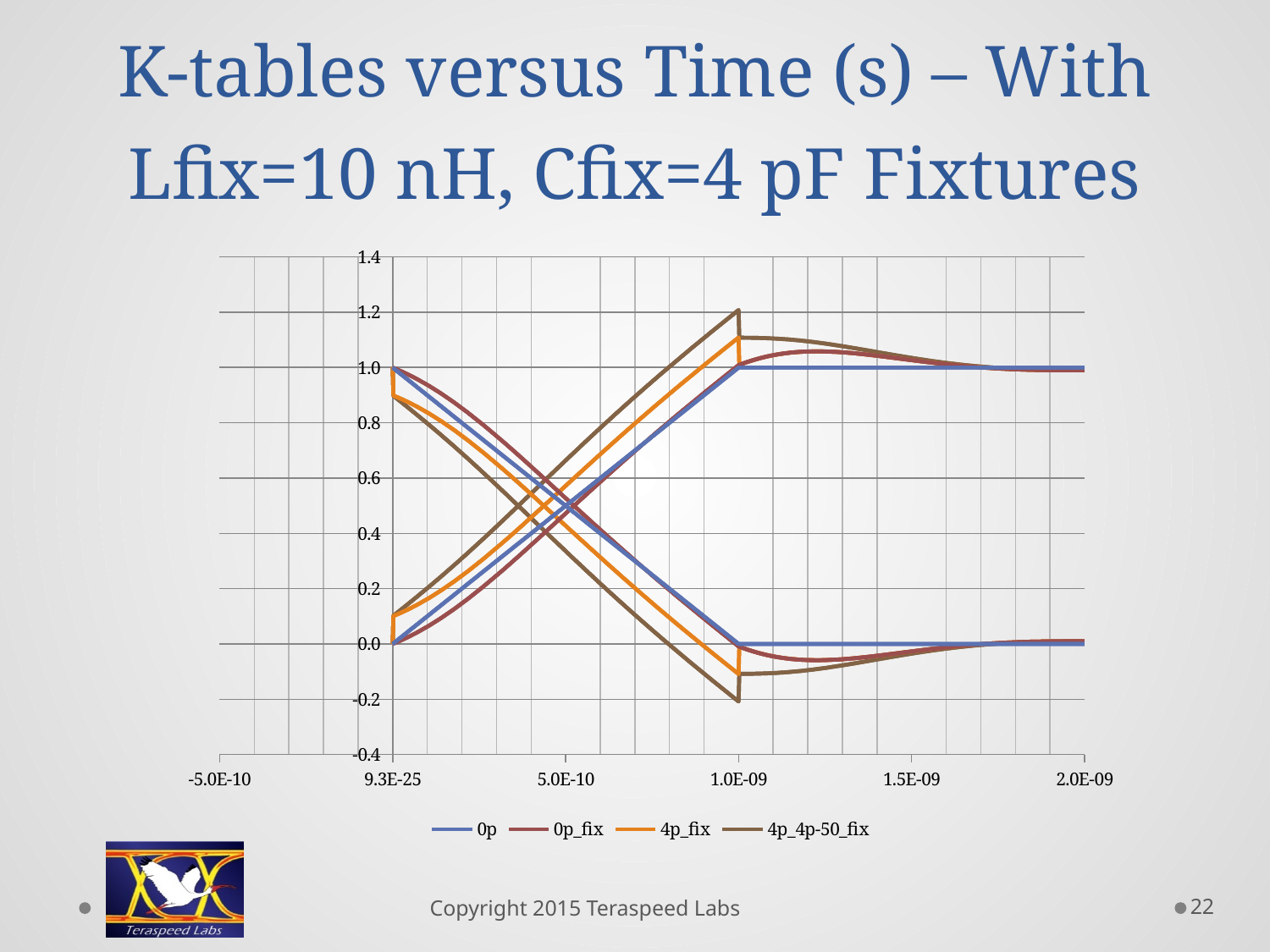
What are the series names listed in the legend? 0p, 0p_fix, 4p_fix, 4p_4p-50_fix How many tick labels are shown on the x axis? 6 Is the peak value of the 4p_fix series greater or less than 1.0? greater Which series dips to the lowest value on the chart? 4p_4p-50_fix Is the lowest value of the 4p_4p-50_fix series greater or less than 0.0? less Is the peak value of the 4p_4p-50_fix series greater or less than 1.0? greater Between 9.3E-25 and 1.0E-09, does the 0p curve that starts at 0.0 rise or fall? rise What kind of chart is shown on the slide? line chart How many series does the legend list? 4 What is the title of the chart on the slide? K-tables versus Time (s) – With Lfix=10 nH, Cfix=4 pF Fixtures Is the peak of the 4p_4p-50_fix series higher or lower than the peak of the 4p_fix series? higher Which series reaches the highest peak value on the chart? 4p_4p-50_fix